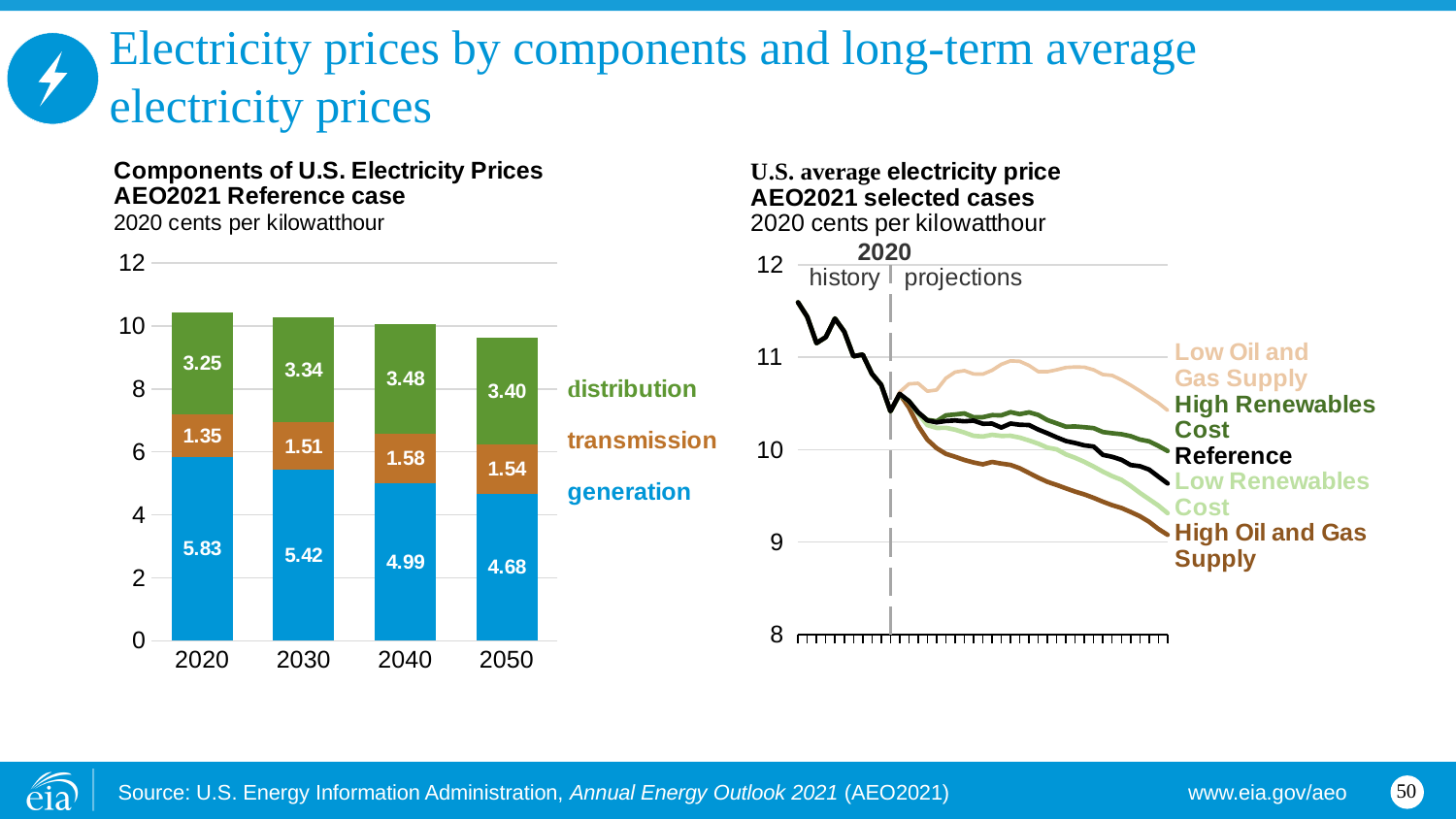
In the Components of U.S. Electricity Prices chart, what is the difference between the generation values for 2020 and 2050? 1.15 In the Components of U.S. Electricity Prices chart, what is the transmission value for 2050? 1.54 What kind of chart is the U.S. average electricity price chart? Line chart In the Components of U.S. Electricity Prices chart, is the distribution value larger in 2030 or in 2040? 2040 How many series does the U.S. average electricity price chart show? 5 In the Components of U.S. Electricity Prices chart, what is the generation value for 2020? 5.83 In the Components of U.S. Electricity Prices chart, which year has the highest generation value? 2020 In the Components of U.S. Electricity Prices chart, how does the generation value change from 2020 to 2050? It falls In the Components of U.S. Electricity Prices chart, what is the distribution value for 2040? 3.48 In the Components of U.S. Electricity Prices chart, which year has the lowest transmission value? 2020 In the Components of U.S. Electricity Prices chart, what is the total of the stacked bar for 2050? 9.62 In the U.S. average electricity price chart, is the value for the High Oil and Gas Supply case at the end of the projection period greater or less than 10? less